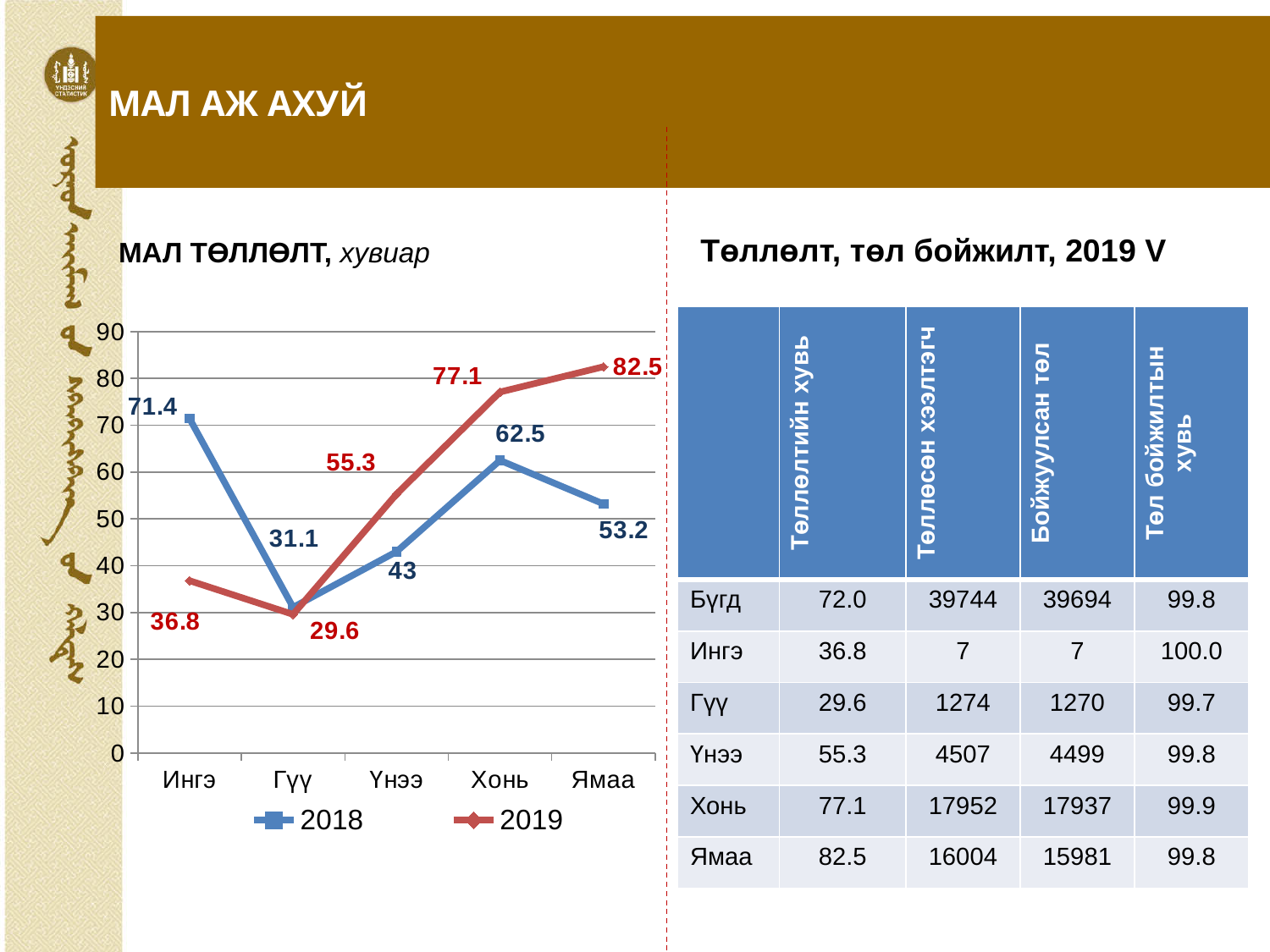
How many series does the legend of the МАЛ ТӨЛЛӨЛТ chart list? 2 How many categories are shown on the x axis of the МАЛ ТӨЛЛӨЛТ chart? 5 Does the 2019 series rise or fall from Гүү to Ямаа in the МАЛ ТӨЛЛӨЛТ chart? rise What is the 2019 value for Үнээ in the МАЛ ТӨЛЛӨЛТ chart? 55.3 What colour is the 2019 line in the МАЛ ТӨЛЛӨЛТ chart? red What is the difference between the 2019 and 2018 values for Ингэ in the МАЛ ТӨЛЛӨЛТ chart? 34.6 Which is larger for Хонь in the МАЛ ТӨЛЛӨЛТ chart, the 2018 value or the 2019 value? 2019 Which category has the highest 2019 value in the МАЛ ТӨЛЛӨЛТ chart? Ямаа Which category has the lowest 2018 value in the МАЛ ТӨЛЛӨЛТ chart? Гүү What is the 2018 value for Ингэ in the МАЛ ТӨЛЛӨЛТ chart? 71.4 What is the 2019 value for Ямаа in the МАЛ ТӨЛЛӨЛТ chart? 82.5 What type of chart is the МАЛ ТӨЛЛӨЛТ chart? line chart